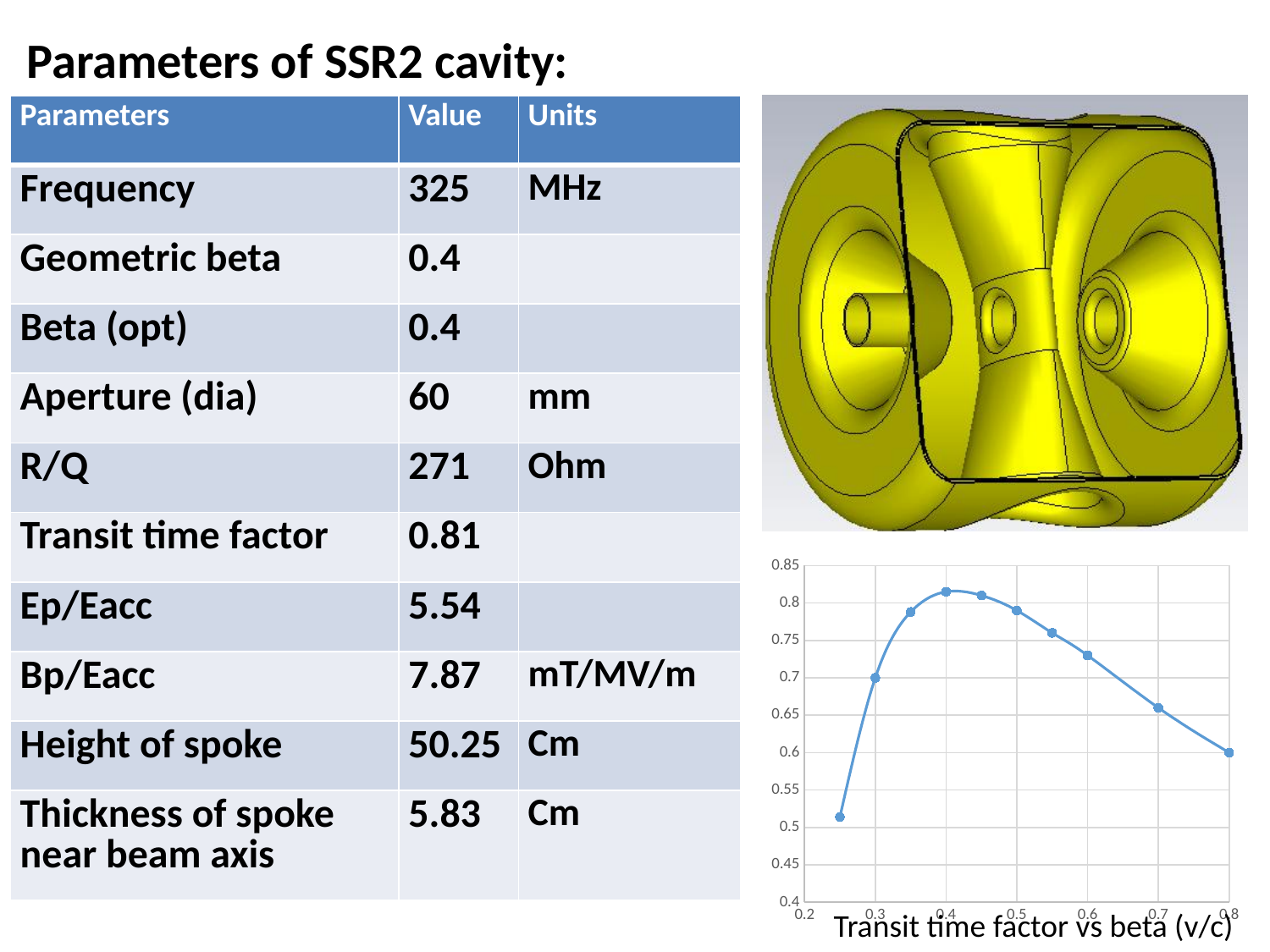
What is the title of the chart on the slide? Transit time factor vs beta (v/c) How many data points are plotted on the transit time factor chart? 10 On the transit time factor chart, is the transit time factor at beta 0.5 greater or less than 0.75? greater What is the highest value shown on the vertical axis of the transit time factor chart? 0.85 On the transit time factor chart, which has the higher transit time factor: beta 0.3 or beta 0.8? beta 0.3 On the transit time factor chart, is the transit time factor at beta 0.25 greater or less than 0.55? less On the transit time factor chart, is the transit time factor at beta 0.6 greater or less than 0.75? less What kind of chart is shown at the bottom right of the slide? line chart On the transit time factor chart, does the transit time factor rise or fall as beta increases from 0.5 to 0.8? fall